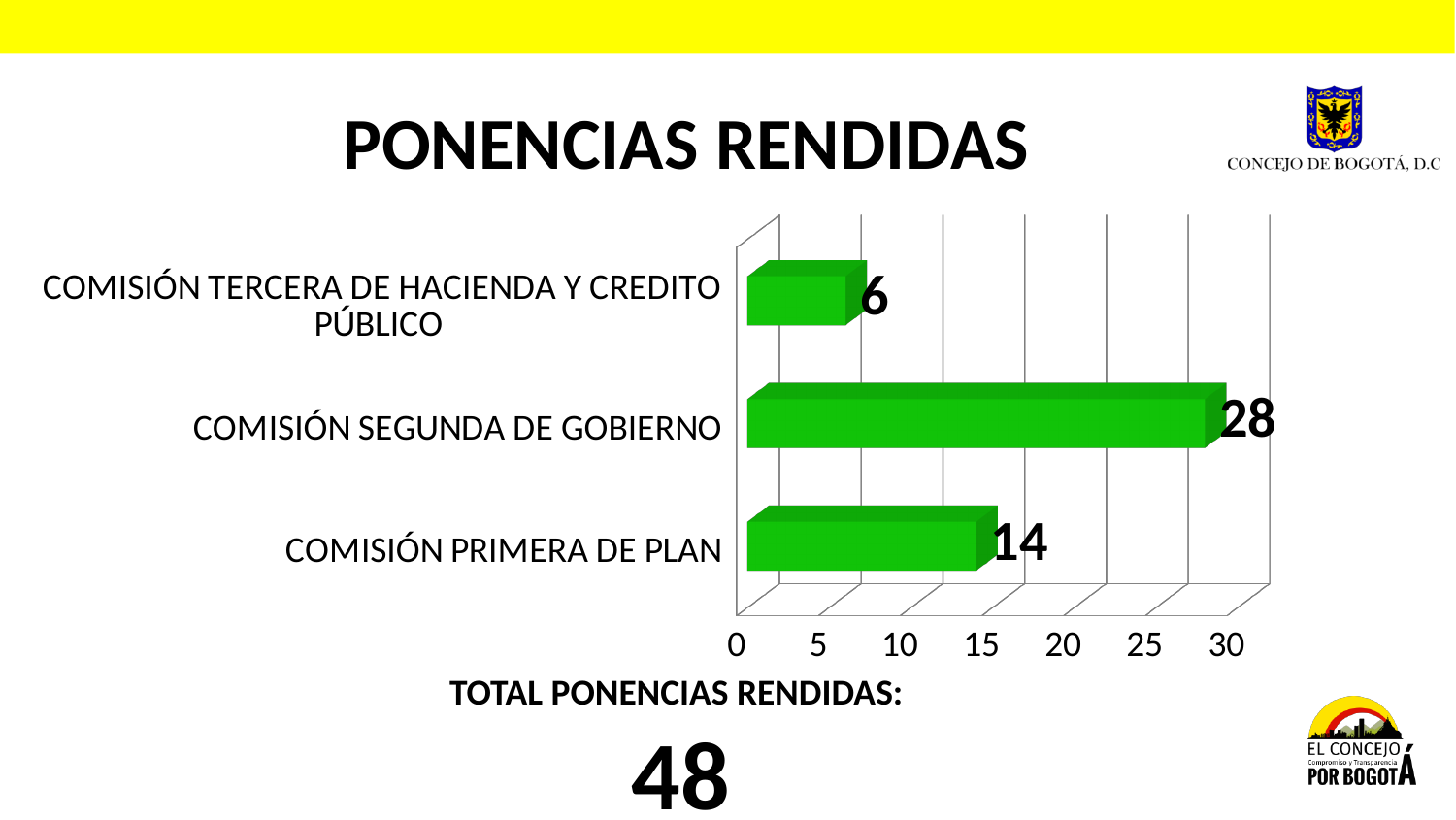
Which is larger, the value for COMISIÓN PRIMERA DE PLAN or the value for COMISIÓN TERCERA DE HACIENDA Y CREDITO PÚBLICO? COMISIÓN PRIMERA DE PLAN What kind of chart is shown on the slide? bar chart What is the title of the slide containing the chart? PONENCIAS RENDIDAS What is the value for COMISIÓN SEGUNDA DE GOBIERNO? 28 Is the value for COMISIÓN SEGUNDA DE GOBIERNO greater or less than 25? greater What is the value for COMISIÓN TERCERA DE HACIENDA Y CREDITO PÚBLICO? 6 What is the difference between the values for COMISIÓN SEGUNDA DE GOBIERNO and COMISIÓN PRIMERA DE PLAN? 14 What is the difference between the values for COMISIÓN PRIMERA DE PLAN and COMISIÓN TERCERA DE HACIENDA Y CREDITO PÚBLICO? 8 Which category has the lowest value? COMISIÓN TERCERA DE HACIENDA Y CREDITO PÚBLICO Which category has the highest value? COMISIÓN SEGUNDA DE GOBIERNO What is the value for COMISIÓN PRIMERA DE PLAN? 14 How many categories are shown in the chart? 3